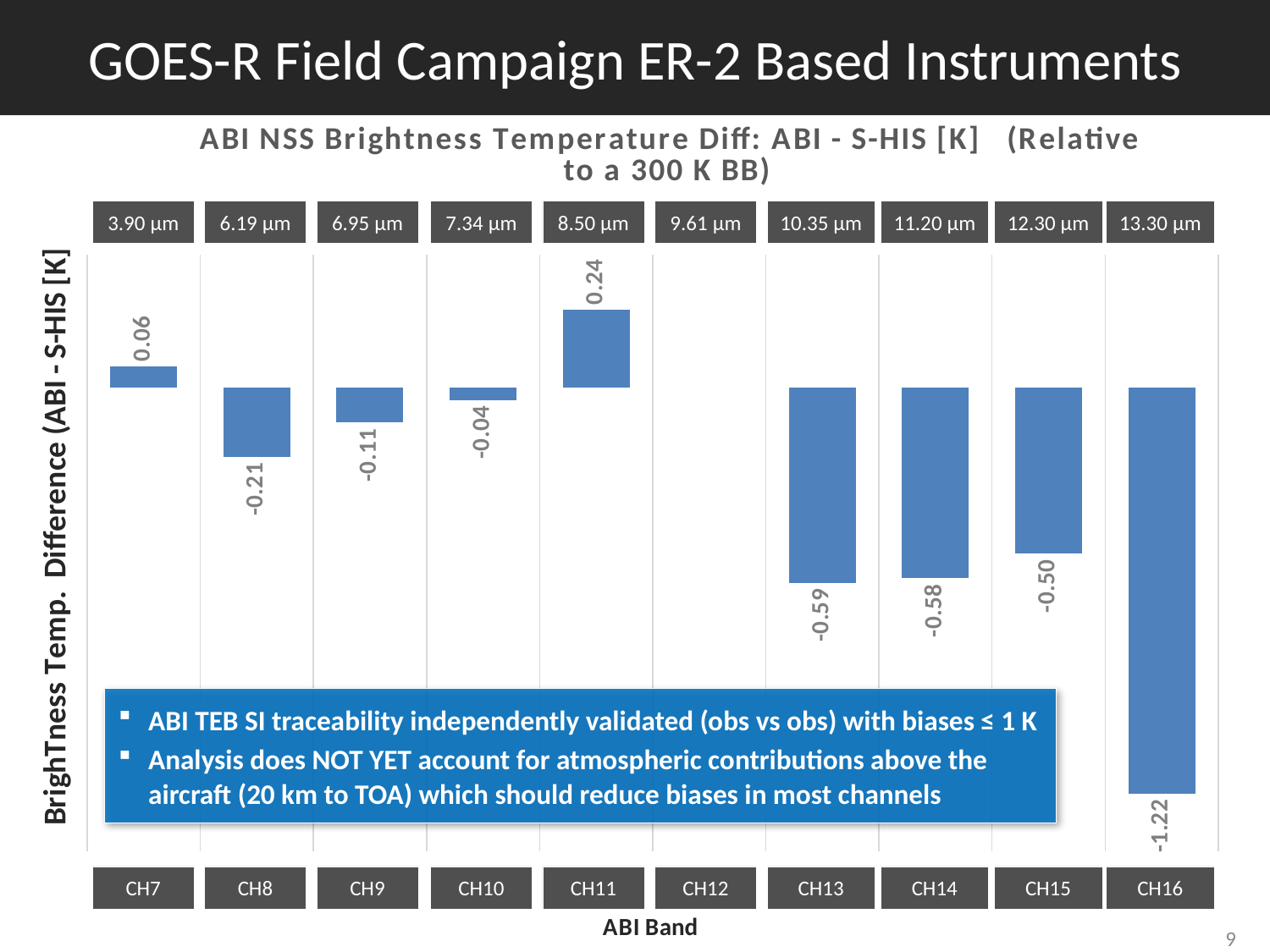
How many ABI band labels are shown along the x axis? 10 What is the difference between the values for CH11 and CH7? 0.18 What is the value shown for CH8? -0.21 What is the value plotted for CH16? -1.22 Which wavelength label is shown above the CH11 bar? 8.50 µm What is the label of the x axis? ABI Band What is the brightness temperature difference value for CH11? 0.24 What kind of chart is shown on the slide? Bar chart Which ABI band has the highest (most positive) brightness temperature difference? CH11 Which ABI band has the lowest (most negative) brightness temperature difference? CH16 Which has the larger value, CH8 or CH9? CH9 What is the value shown for CH15? -0.50